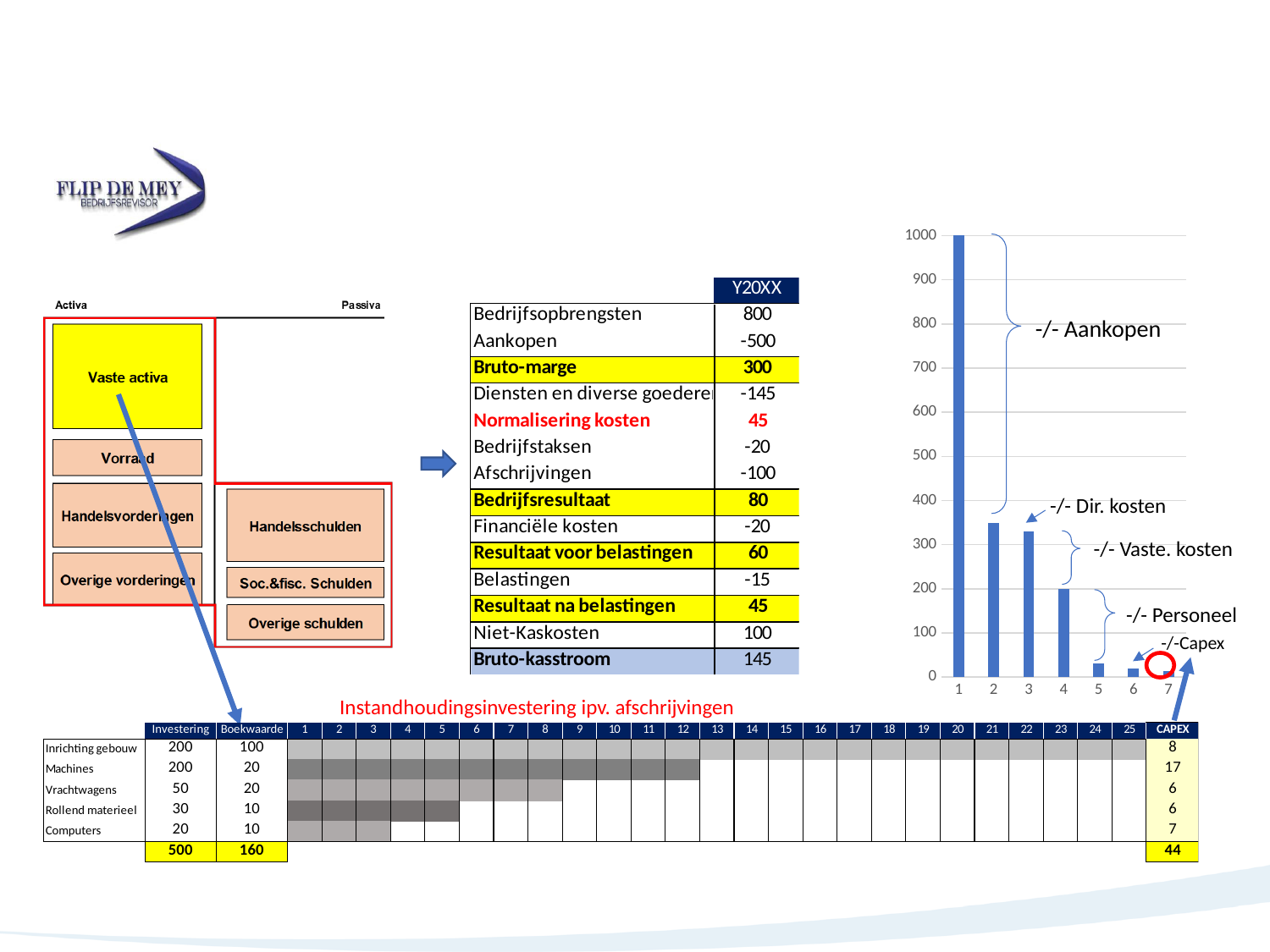
Do the bar values rise or fall from category 1 to category 7 in the bar chart? fall What kind of chart is shown on the right side of the slide? bar chart In the bar chart, which is larger: the bar for category 1 or the bar for category 2? 1 Which category has the highest bar in the bar chart? 1 Is the value for category 5 in the bar chart greater or less than 100? less Is the value for category 4 in the bar chart greater or less than 300? less What annotation is written next to the bracket beside the tallest bar in the bar chart? -/- Aankopen What value does the bar for category 1 reach in the bar chart? 1000 How many categories are shown on the x axis of the bar chart? 7 Is the value for category 2 in the bar chart greater or less than 300? greater In the bar chart, which is larger: the bar for category 4 or the bar for category 5? 4